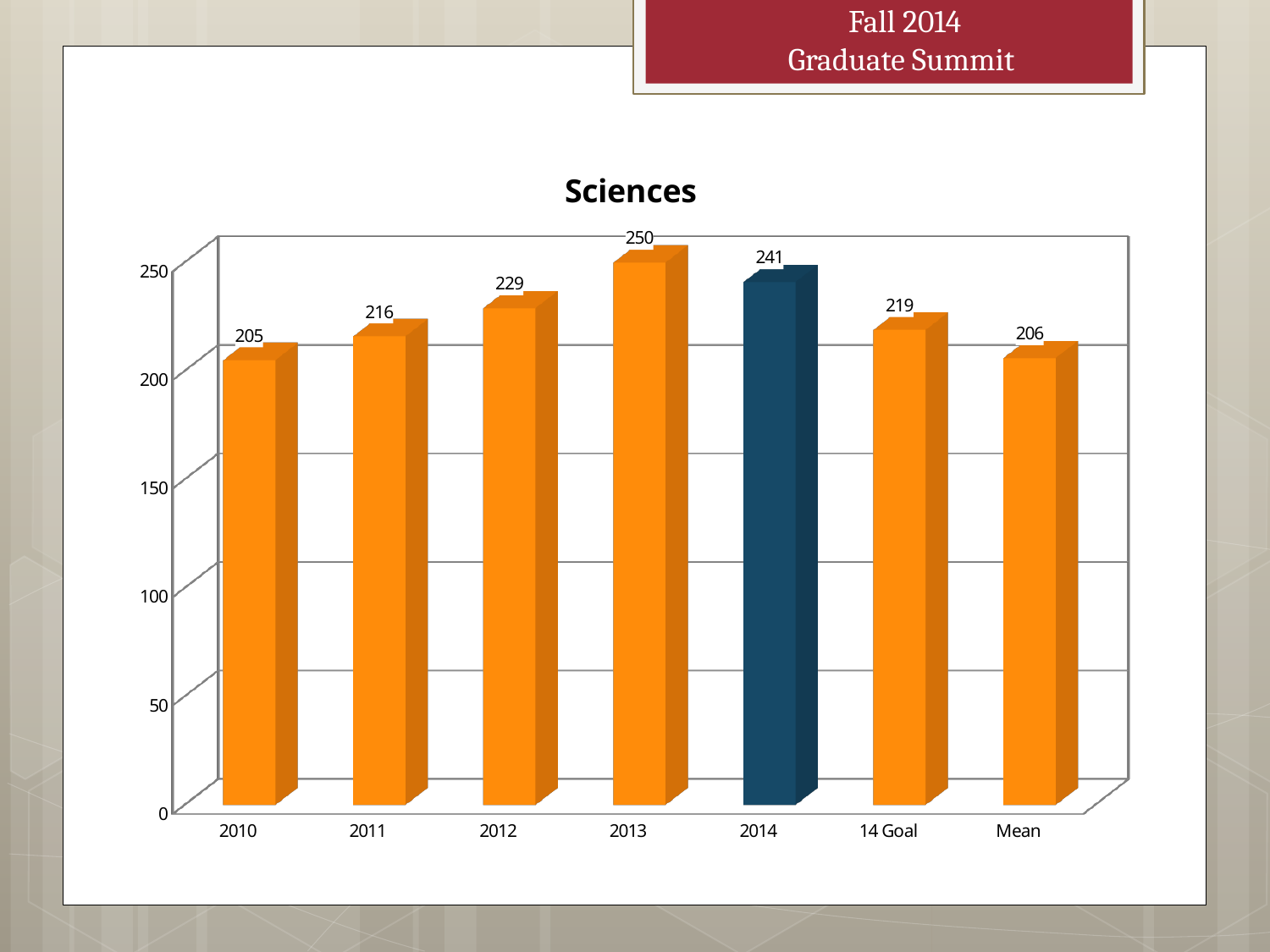
What is the value for Mean in the Sciences chart? 206 What is the difference between the values for 2013 and 2010? 45 How many categories are shown on the x axis of the Sciences chart? 7 Which is larger, the value for 2012 or the value for 14 Goal? 2012 Which category has the highest value in the Sciences chart? 2013 Which category has the lowest value in the Sciences chart? 2010 What is the difference between the values for 2014 and 14 Goal? 22 Do the values rise or fall from 2010 to 2013? rise What is the value for 14 Goal in the Sciences chart? 219 What is the value for 2014 in the Sciences chart? 241 What kind of chart is shown on the slide? bar chart Is the value for 2011 greater or less than 200? greater